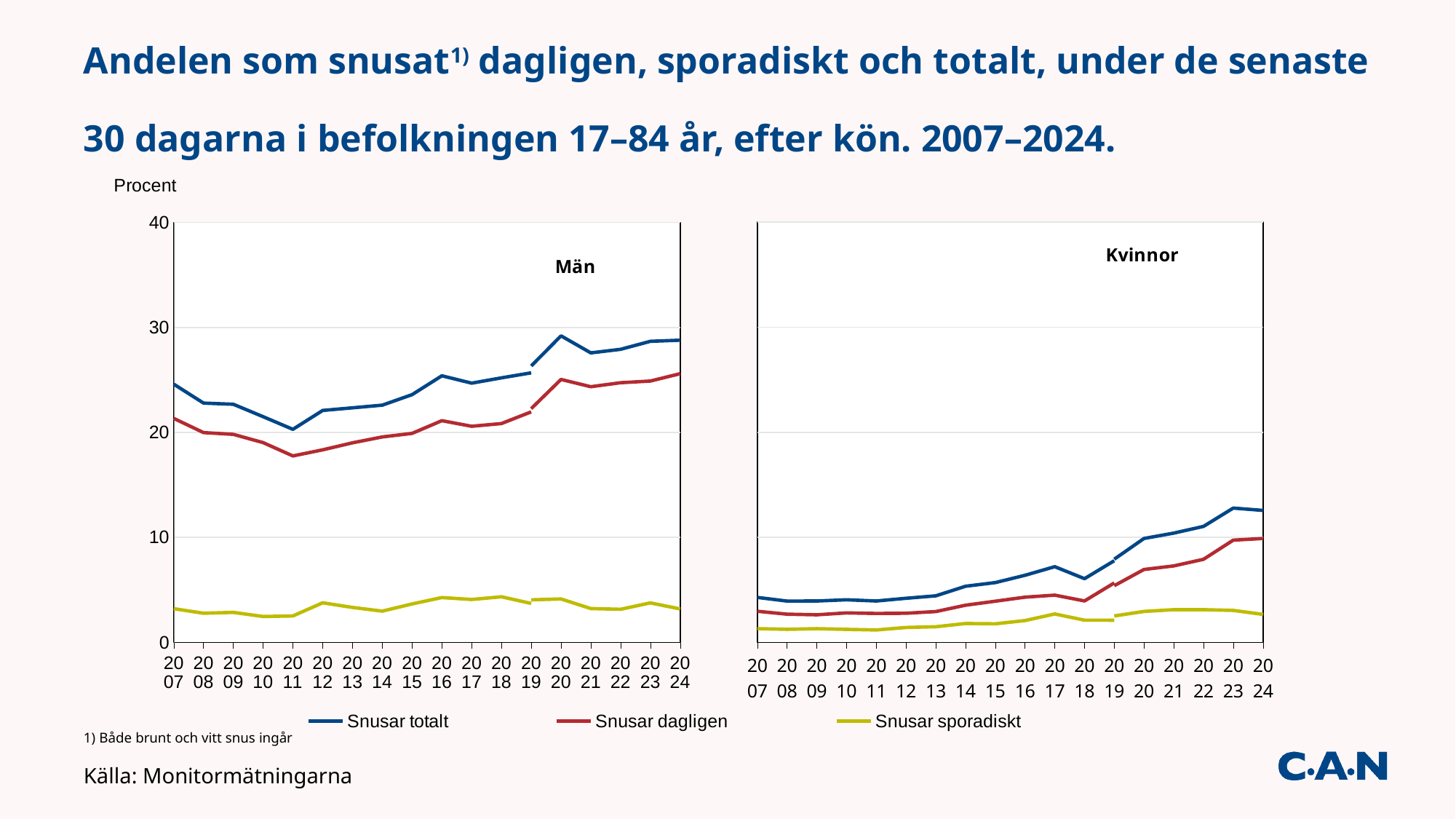
What colour is the Snusar dagligen line in the legend? red In the Kvinnor chart, does Snusar totalt rise or fall from 2007 to 2024? rise In the Män chart, is the value for Snusar dagligen in 2011 greater or less than 20? less In the Kvinnor chart, how many years are plotted along the x axis? 18 In the Kvinnor chart, is the value for Snusar totalt in 2024 greater or less than 10? greater How many series does the legend list? 3 In the Män chart, is the value for Snusar totalt in 2024 greater or less than 20? greater In the Män chart, in which year is Snusar totalt at its lowest? 2011 What kind of chart is used for the Män panel? line chart Which is larger in 2024: Snusar totalt in the Män chart or Snusar totalt in the Kvinnor chart? Män In the Kvinnor chart, which series has the lowest values throughout? Snusar sporadiskt